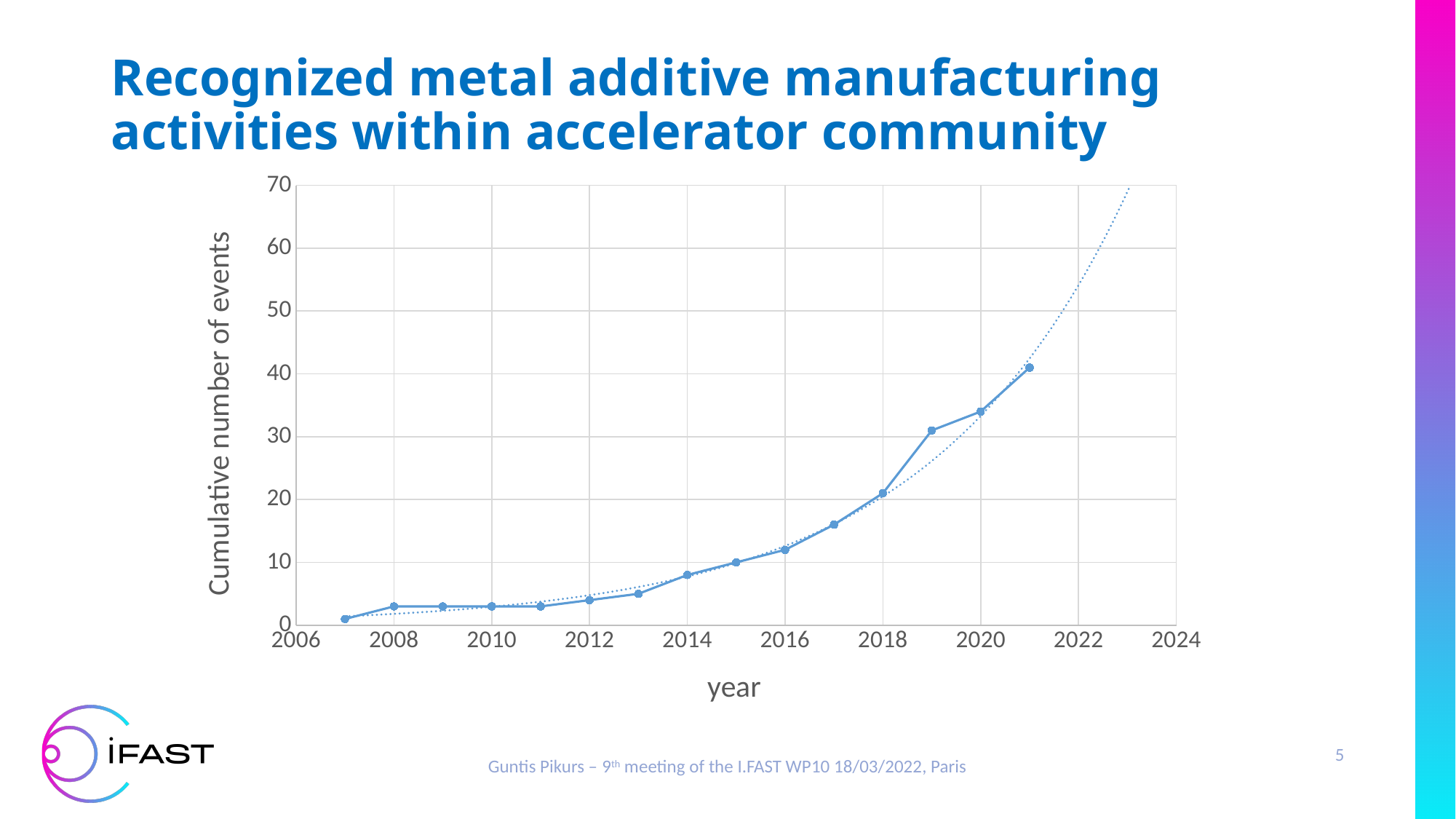
Is the value for 2021 greater or less than 40? greater What kind of chart is shown on the slide? line chart What is the label of the vertical axis? Cumulative number of events Which year has the highest cumulative number of events? 2021 Do the values rise or fall as the year increases along the x axis? rise Which year has the lowest cumulative number of events? 2007 Is the value for 2019 greater or less than 30? greater What is the label of the horizontal axis? year Which year has the larger cumulative number of events, 2018 or 2019? 2019 How many data points are plotted on the solid line? 15 Is the value for 2014 greater or less than 10? less